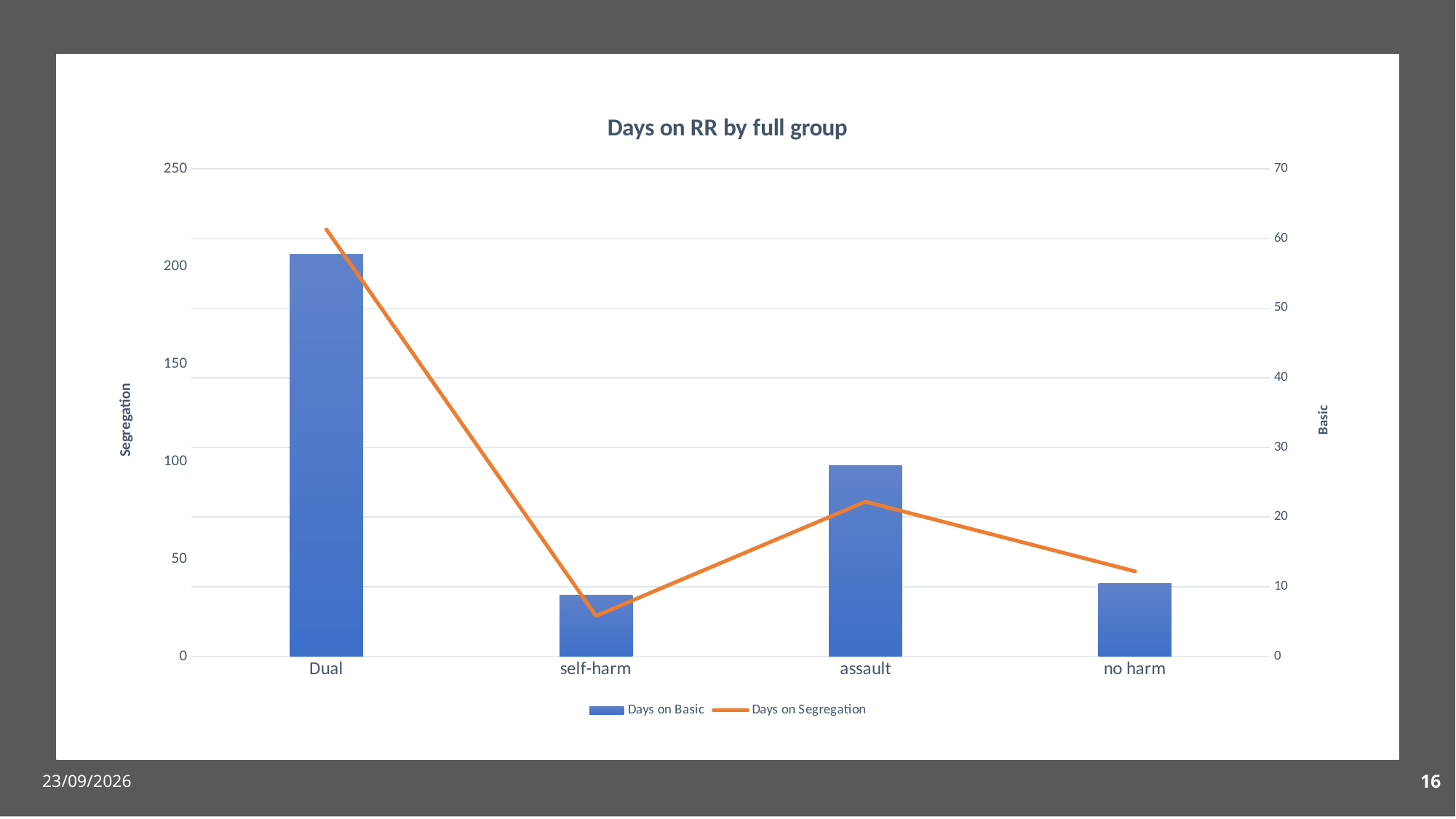
Which category has the lowest value for Days on Segregation? self-harm What is the title of the right-hand vertical axis? Basic How many series does the legend list? 2 Is the Days on Basic value for Dual greater or less than 50 on the right-hand axis? greater Which category has the highest value for Days on Basic? Dual Which category has the highest value for Days on Segregation? Dual What kind of chart is this? Combined bar and line chart Is the Days on Segregation value for assault greater or less than 100? less What is the title of the chart? Days on RR by full group Which is larger for Days on Basic: assault or no harm? assault How many categories are shown on the x axis? 4